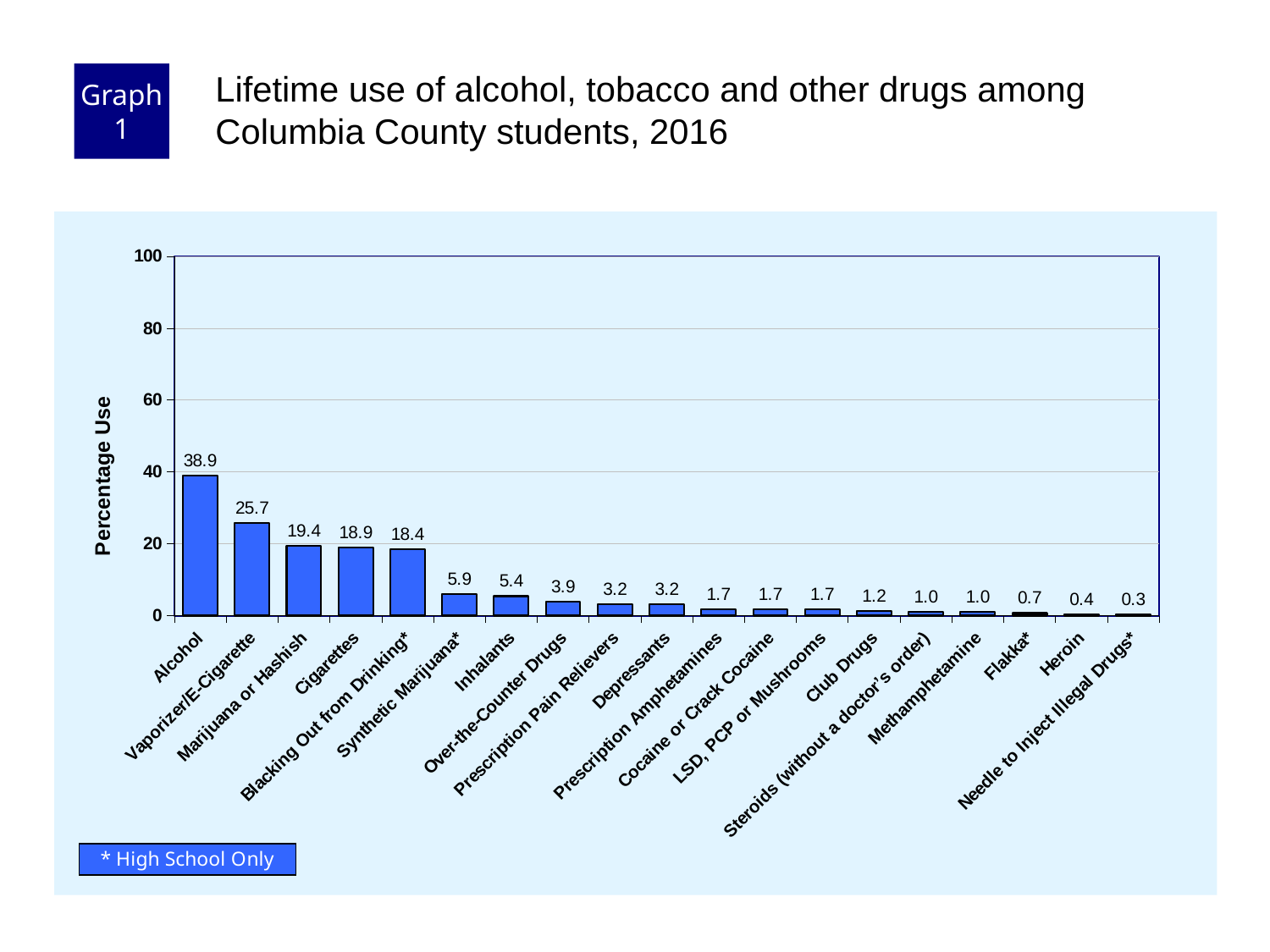
What is the difference in percentage use between Alcohol and Vaporizer/E-Cigarette? 13.2 How many categories are shown on the chart? 19 Which category has the highest percentage use? Alcohol What is the percentage use for Heroin? 0.4 What is the percentage use for Alcohol? 38.9 What is the percentage use for Inhalants? 5.4 Which has a higher percentage use, Cigarettes or Blacking Out from Drinking*? Cigarettes Which category has the lowest percentage use? Needle to Inject Illegal Drugs* What is the percentage use for Vaporizer/E-Cigarette? 25.7 What kind of chart is shown on the slide? Bar chart What is the label of the y axis? Percentage Use Is the value for Marijuana or Hashish greater or less than 20? less